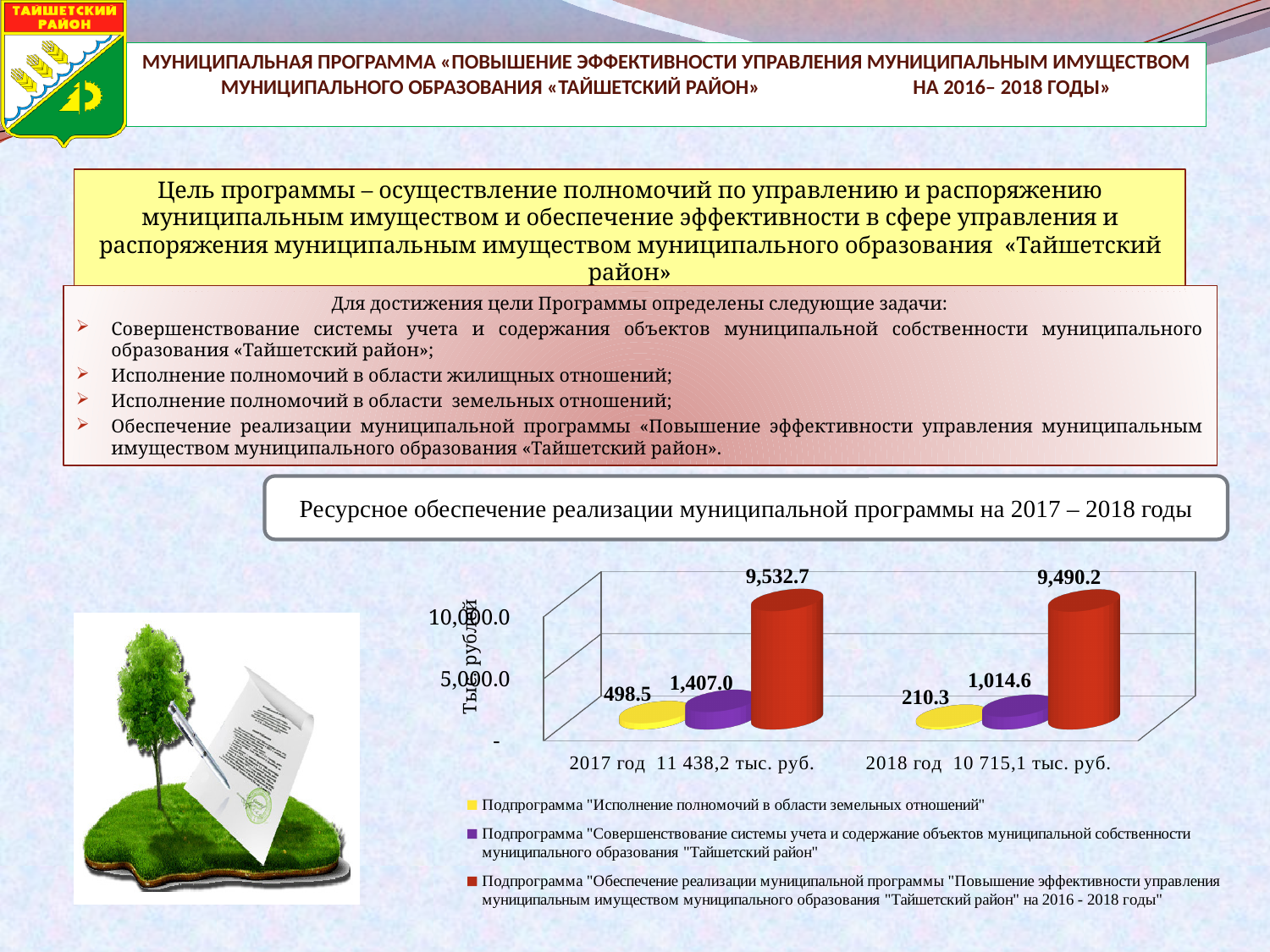
What unit is shown on the vertical axis of the chart? Тыс. рублей What is the value for the subprogram "Обеспечение реализации муниципальной программы" in 2018? 9,490.2 What is the value for the subprogram "Исполнение полномочий в области земельных отношений" in 2018? 210.3 Which subprogram has the lowest value in 2018? Подпрограмма "Исполнение полномочий в области земельных отношений" What is the value for the subprogram "Совершенствование системы учета и содержание объектов муниципальной собственности" in 2017? 1,407.0 What is the value for the subprogram "Исполнение полномочий в области земельных отношений" in 2017? 498.5 Which subprogram has the highest value in 2017? Подпрограмма "Обеспечение реализации муниципальной программы "Повышение эффективности управления муниципальным имуществом муниципального образования "Тайшетский район" на 2016 - 2018 годы" How many series does the chart legend list? 3 How many year categories are shown on the x axis of the chart? 2 Is the value for the subprogram "Обеспечение реализации муниципальной программы" in 2017 larger or smaller than in 2018? larger What is the difference between the 2017 and 2018 values for the subprogram "Совершенствование системы учета и содержание объектов муниципальной собственности"? 392.4 What type of chart is shown on the slide? bar chart